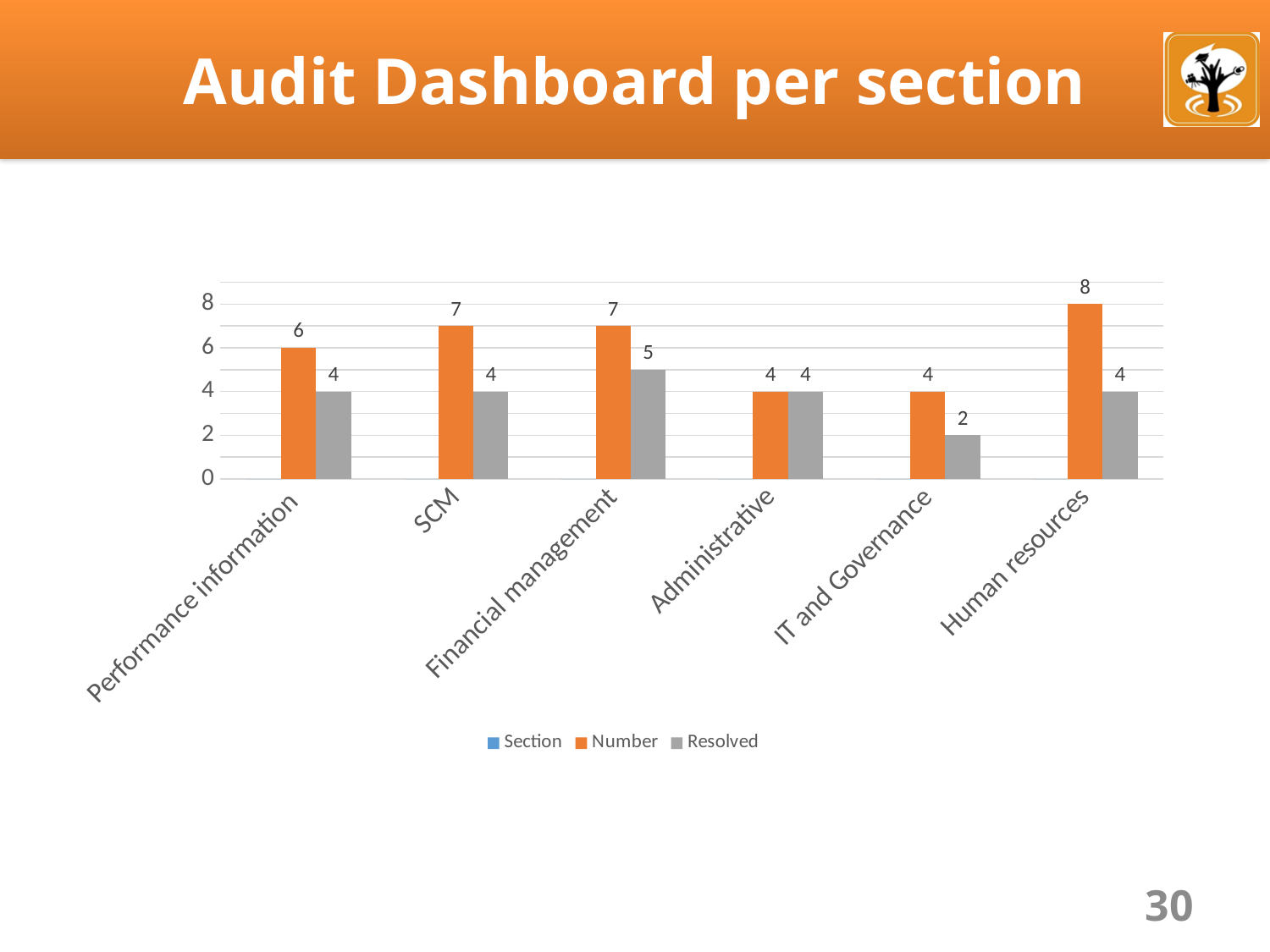
What is the Number value for Performance information? 6 What is the Number value for Human resources? 8 What is the difference between the Number and Resolved values for Human resources? 4 What is the Resolved value for IT and Governance? 2 Which category has the highest Number value? Human resources How many categories are shown on the x axis? 6 Which category has the lowest Resolved value? IT and Governance What kind of chart is shown on the slide? Bar chart What is the Resolved value for Financial management? 5 How many series does the legend list? 3 What is the title of the slide containing the chart? Audit Dashboard per section Which is larger for SCM, the Number value or the Resolved value? Number